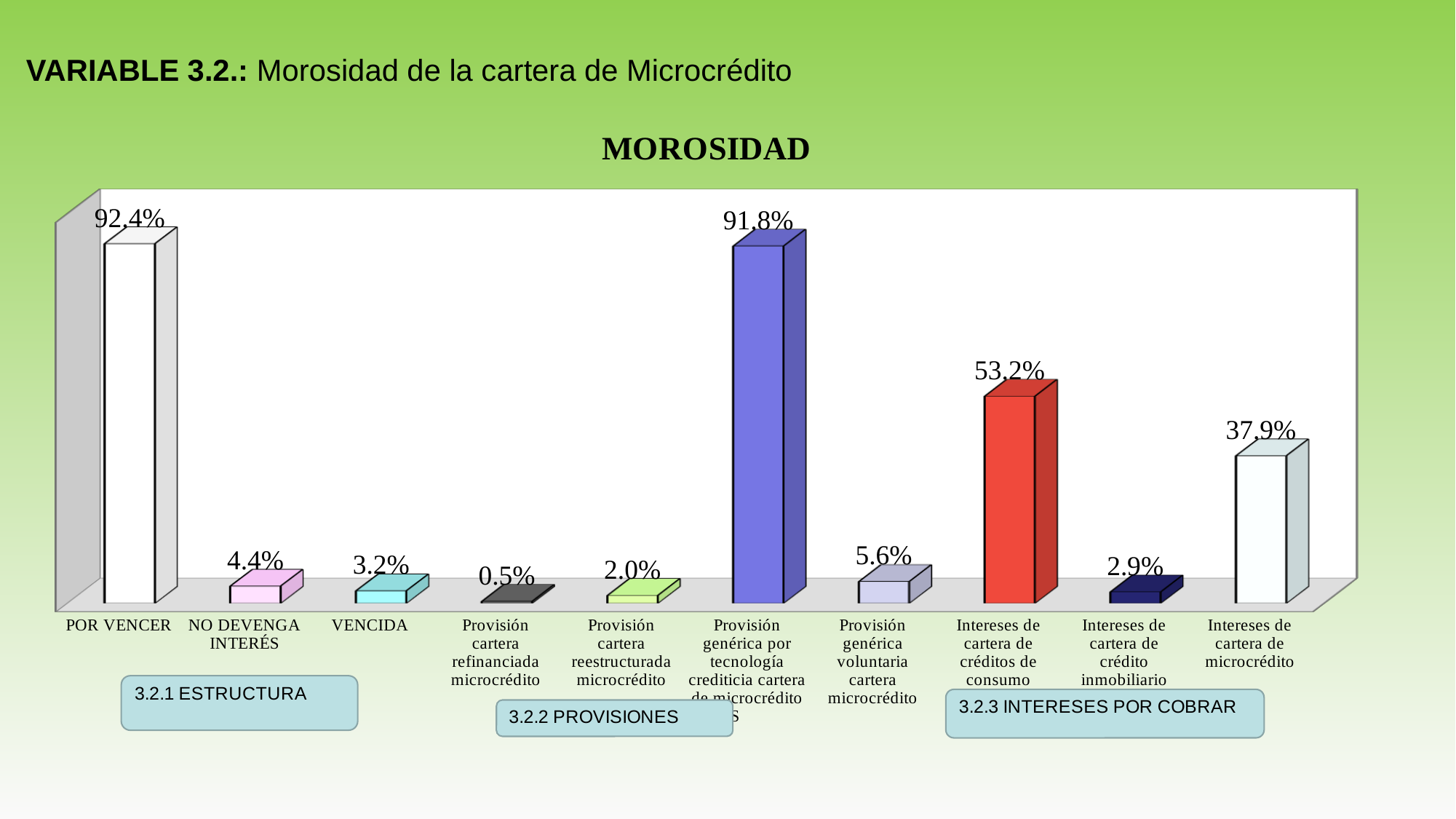
What is the difference between the values for POR VENCER and Provisión genérica por tecnología crediticia cartera de microcrédito? 0.6% What is the value for Provisión genérica voluntaria cartera microcrédito? 5.6% What is the value for Intereses de cartera de microcrédito? 37.9% Which category has the lowest value? Provisión cartera refinanciada microcrédito What is the value for POR VENCER? 92.4% Which is larger, the value for NO DEVENGA INTERÉS or the value for VENCIDA? NO DEVENGA INTERÉS What is the difference between the values for Intereses de cartera de créditos de consumo and Intereses de cartera de microcrédito? 15.3% What kind of chart is shown on the slide? Bar chart What is the value for Intereses de cartera de créditos de consumo? 53.2% How many categories are shown in the chart? 10 What is the title of the chart? MOROSIDAD Which category has the highest value? POR VENCER